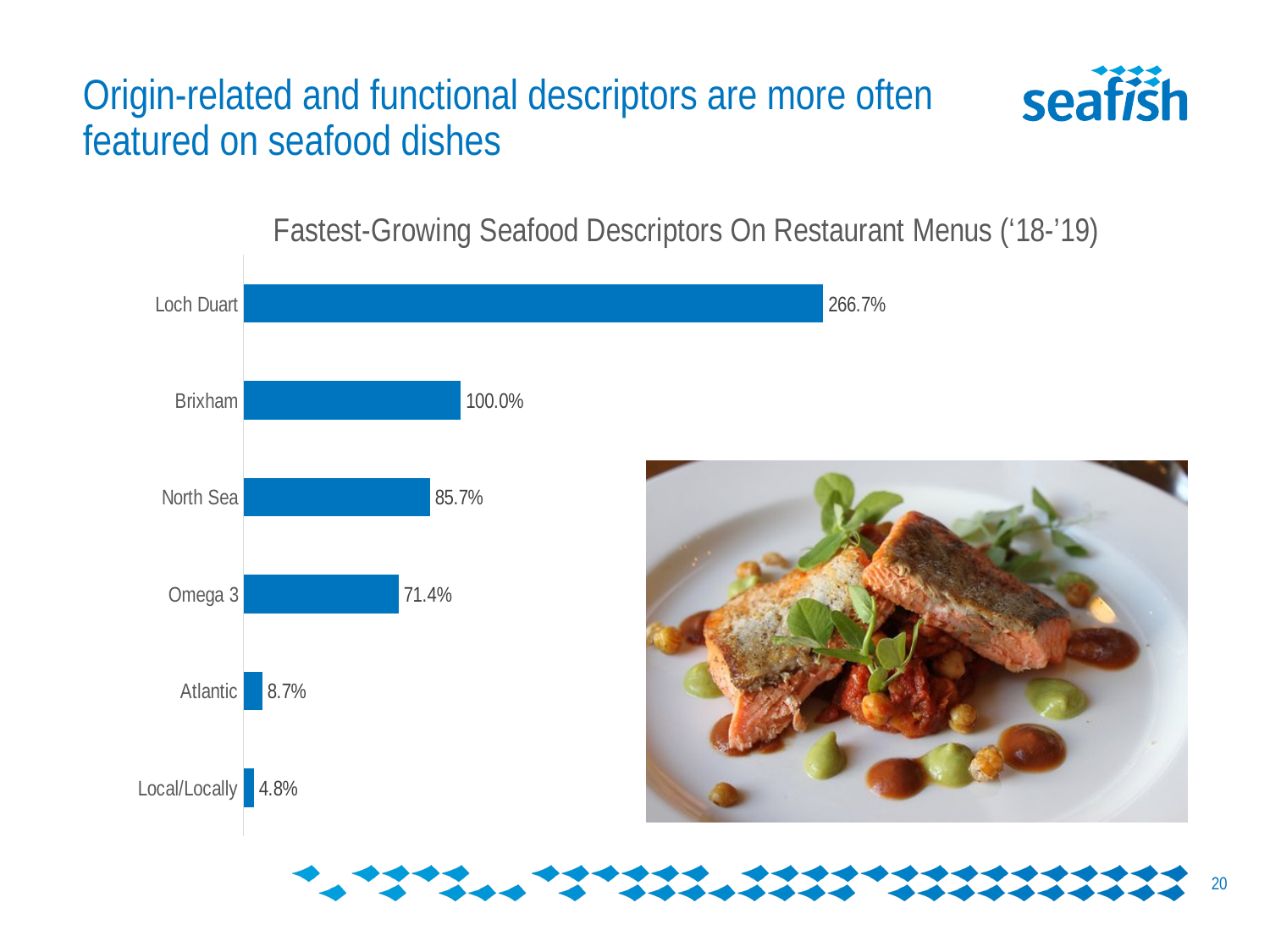
What is the value for Loch Duart? 266.7% What is the value for Local/Locally? 4.8% Which descriptor has the highest value? Loch Duart What is the value for Brixham? 100.0% How many descriptors are shown in the chart? 6 What is the value for North Sea? 85.7% Which descriptor has the lowest value? Local/Locally Which is larger, the value for North Sea or the value for Omega 3? North Sea What kind of chart is shown on the slide? Bar chart What is the title of the chart? Fastest-Growing Seafood Descriptors On Restaurant Menus ('18-'19) What is the difference between the values for Atlantic and Local/Locally? 3.9% What is the difference between the values for Brixham and Omega 3? 28.6%